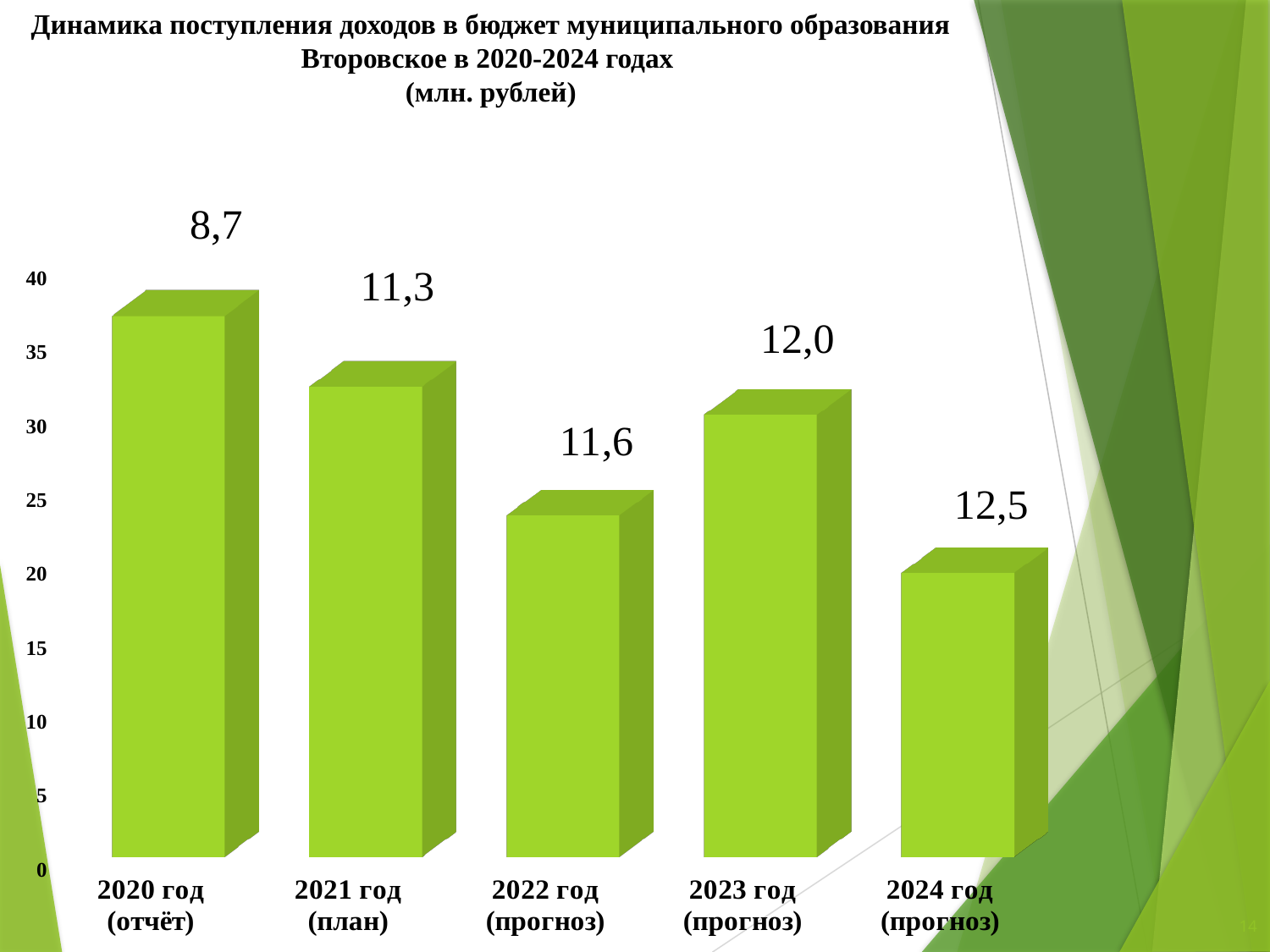
How many years (categories) are shown on the chart? 5 What is the difference between the labelled values for 2024 год (прогноз) and 2020 год (отчёт)? 3,8 What is the value shown for 2020 год (отчёт)? 8,7 What is the difference between the labelled values for 2023 год (прогноз) and 2022 год (прогноз)? 0,4 What is the value shown for 2023 год (прогноз)? 12,0 What is the highest tick value shown on the vertical axis? 40 What is the value shown for 2022 год (прогноз)? 11,6 What is the value shown for 2024 год (прогноз)? 12,5 What is the value shown for 2021 год (план)? 11,3 What kind of chart is shown on the slide? Bar chart In what units are the values on the chart expressed, according to the title? млн. рублей